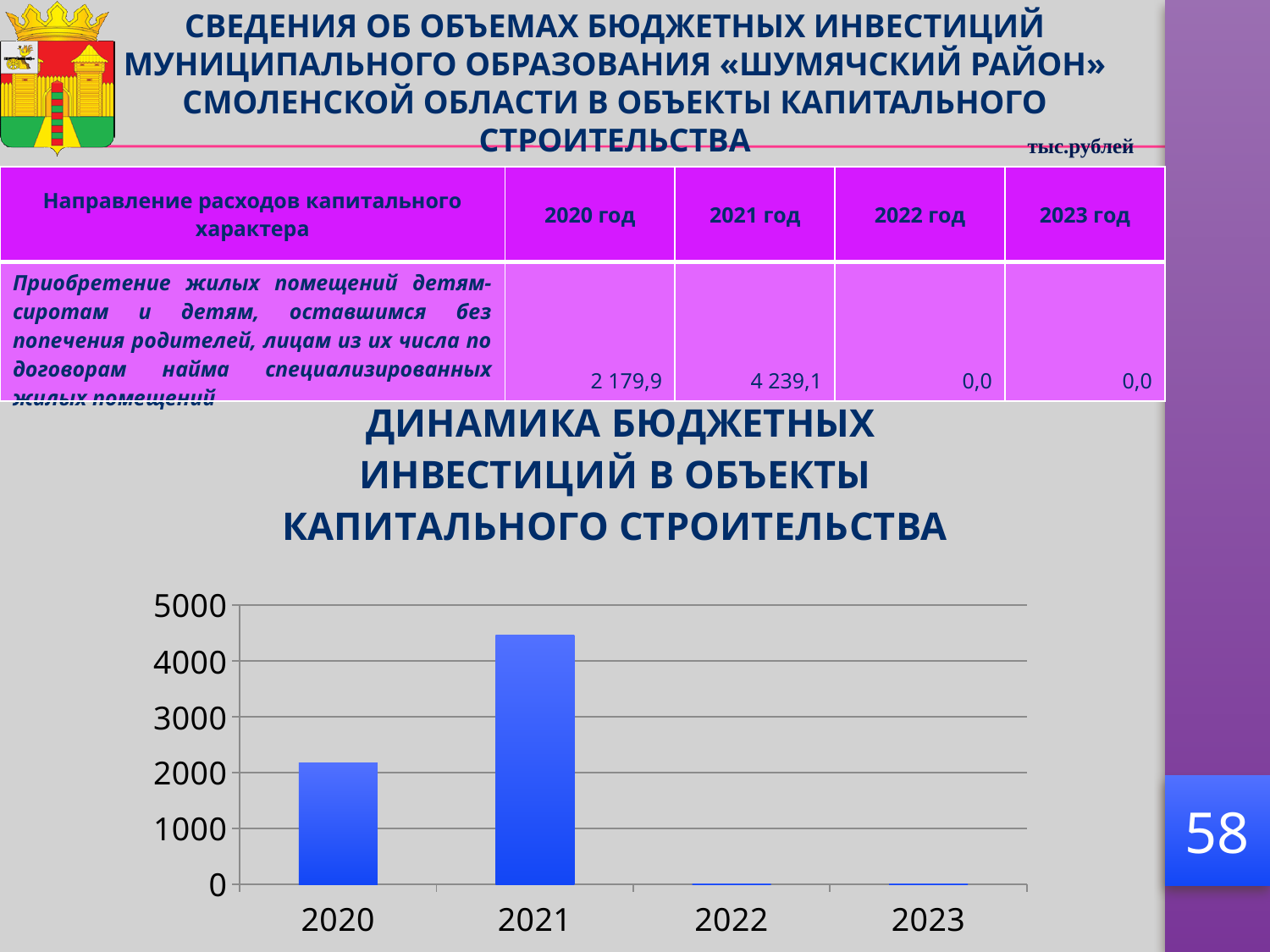
Is the value for 2022 greater or less than 1000? less What is the title of the chart? ДИНАМИКА БЮДЖЕТНЫХ ИНВЕСТИЦИЙ В ОБЪЕКТЫ КАПИТАЛЬНОГО СТРОИТЕЛЬСТВА What is the highest tick value shown on the vertical axis of the chart? 5000 What kind of chart is shown on the slide? bar chart Is the value for 2021 greater or less than 4000? greater Which year has the highest bar in the chart? 2021 How many years are shown on the x axis of the chart? 4 Is the value for 2020 greater or less than 3000? less Do the values rise or fall from 2021 to 2022? fall Which is larger, the value for 2020 or the value for 2023? 2020 Which is larger, the value for 2020 or the value for 2021? 2021